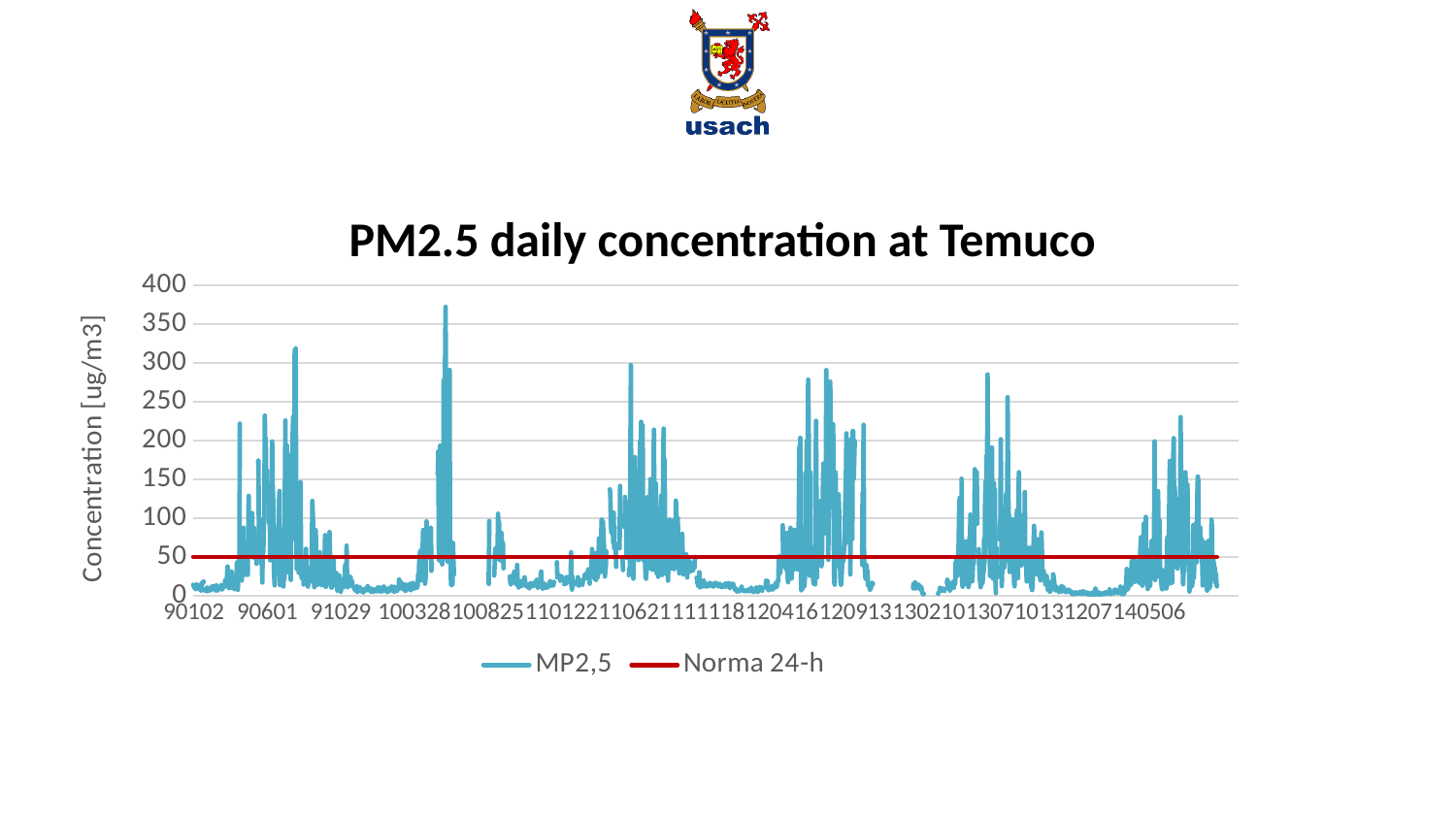
Is the MP2,5 value at the first x-axis label 90102 greater or less than 50? less What is the title of the chart? PM2.5 daily concentration at Temuco Which series is higher at the x-axis label 91029, MP2,5 or Norma 24-h? Norma 24-h What are the two series named in the legend? MP2,5 and Norma 24-h Is the highest peak of the MP2,5 series greater or less than 350? greater What kind of chart is shown on the slide? line chart At what concentration level does the Norma 24-h line sit? 50 How many series does the legend list? 2 Is the MP2,5 peak near the x-axis label 90601 greater or less than 300? greater What is the highest value shown on the y axis? 400 How many tick labels are shown on the x axis? 14 Is the MP2,5 peak near the x-axis label 100328 greater or less than the peak near 140506? greater